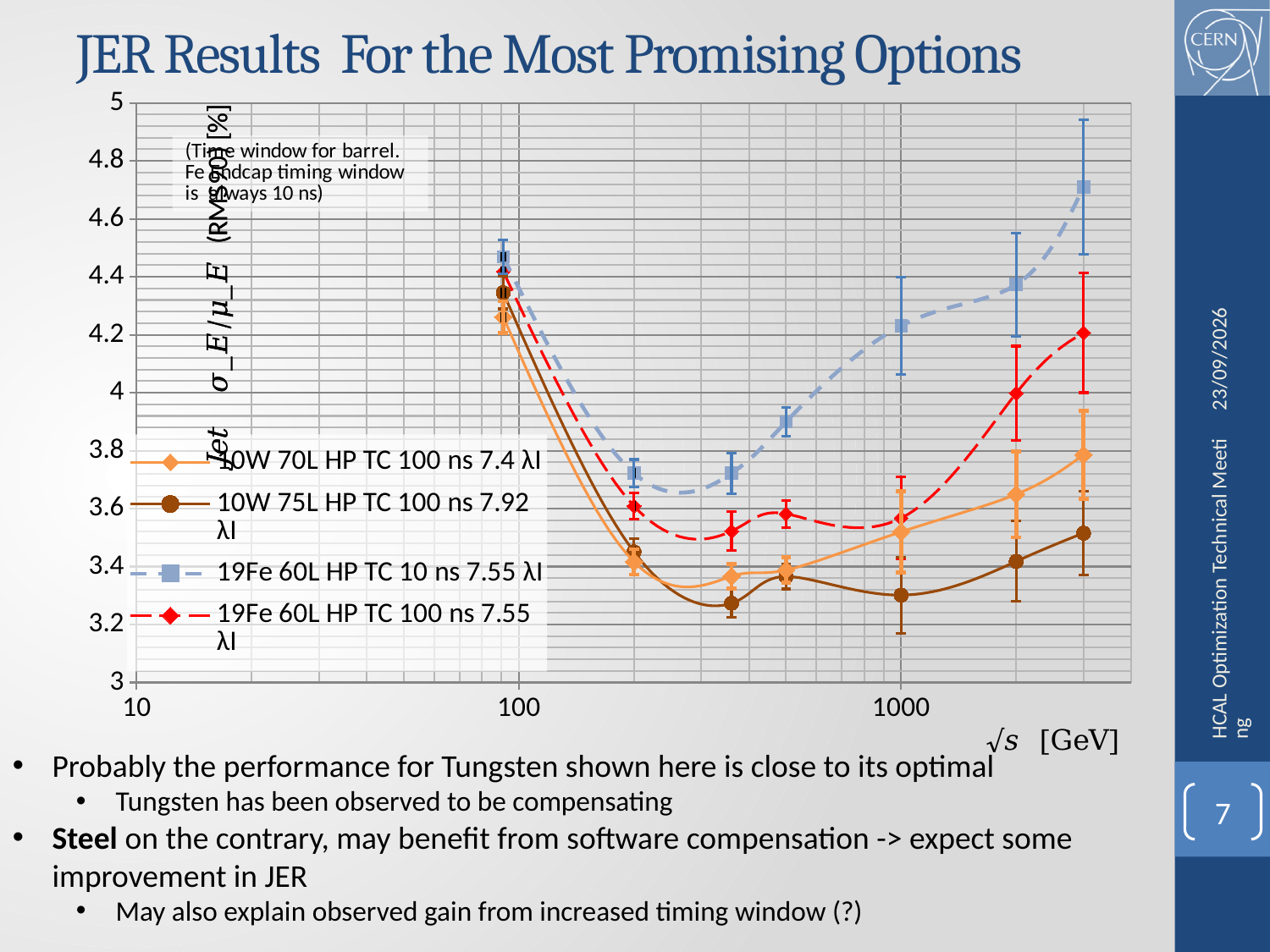
How many series does the legend list? 4 Which series has the lowest value at the rightmost data point (around 3000 GeV)? 10W 75L HP TC 100 ns 7.92 λI Which series has the lowest value at 1000 GeV? 10W 75L HP TC 100 ns 7.92 λI Is the value for the 10W 75L HP TC 100 ns 7.92 λI series at 1000 GeV greater or less than 3.4? less Does the 19Fe 60L HP TC 10 ns 7.55 λI series rise or fall between 200 GeV and 3000 GeV? rise What is the label of the x axis? √s [GeV] What kind of chart is shown on the slide? line chart Which series has the highest value at the rightmost data point (around 3000 GeV)? 19Fe 60L HP TC 10 ns 7.55 λI Is the value for the 19Fe 60L HP TC 10 ns 7.55 λI series at 1000 GeV greater or less than 4? greater At 1000 GeV, which series has the larger value: 19Fe 60L HP TC 100 ns 7.55 λI or 10W 70L HP TC 100 ns 7.4 λI? 19Fe 60L HP TC 100 ns 7.55 λI Is the value for the 19Fe 60L HP TC 10 ns 7.55 λI series at its rightmost point (around 3000 GeV) greater or less than 4.4? greater How many data points does each series have? 7